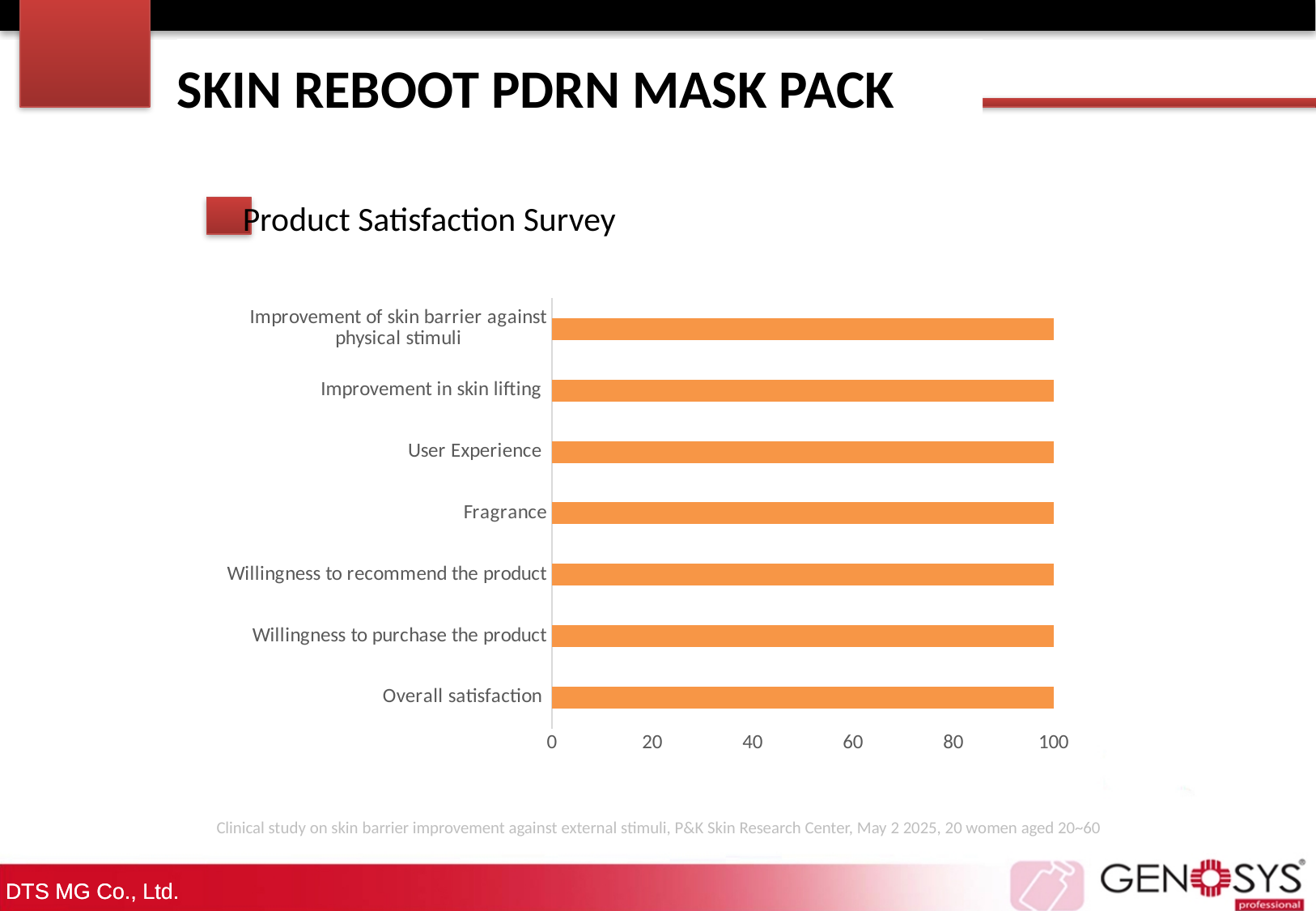
What is the value for Overall satisfaction? 100 What type of chart is shown on the slide? bar chart How many categories are plotted in the chart? 7 What is the value for User Experience? 100 Which category is listed at the top of the chart? Improvement of skin barrier against physical stimuli What is the value for Improvement in skin lifting? 100 Is the value for Willingness to purchase the product greater or less than 80? greater Is the value for Willingness to recommend the product greater or less than 60? greater What is the title of the chart? Product Satisfaction Survey What is the difference between the values for Overall satisfaction and Fragrance? 0 What is the value for Fragrance? 100 What is the highest value shown on the horizontal axis? 100